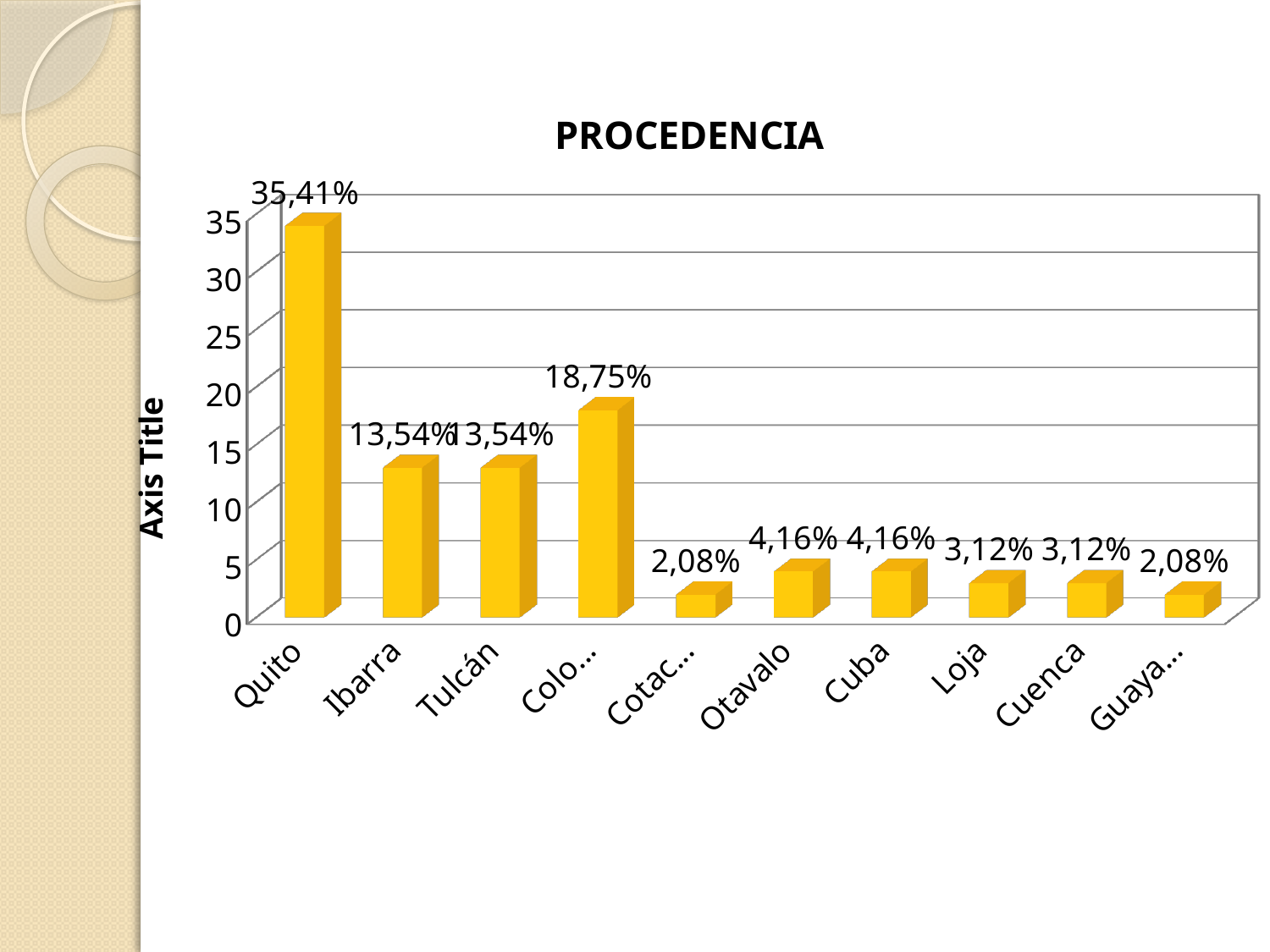
What is the difference between the values for Cuba and Cuenca? 1,04% What is the value for Loja? 3,12% What is the value for Quito? 35,41% How many categories are shown on the x axis? 10 Which is larger, the value for Otavalo or the value for Loja? Otavalo Which category has the highest value? Quito What is the value for Otavalo? 4,16% What is the difference between the values for Quito and Ibarra? 21,87% What is the value for Cuenca? 3,12% What kind of chart is this? Bar chart What is the value for Ibarra? 13,54% What is the title of the chart? PROCEDENCIA